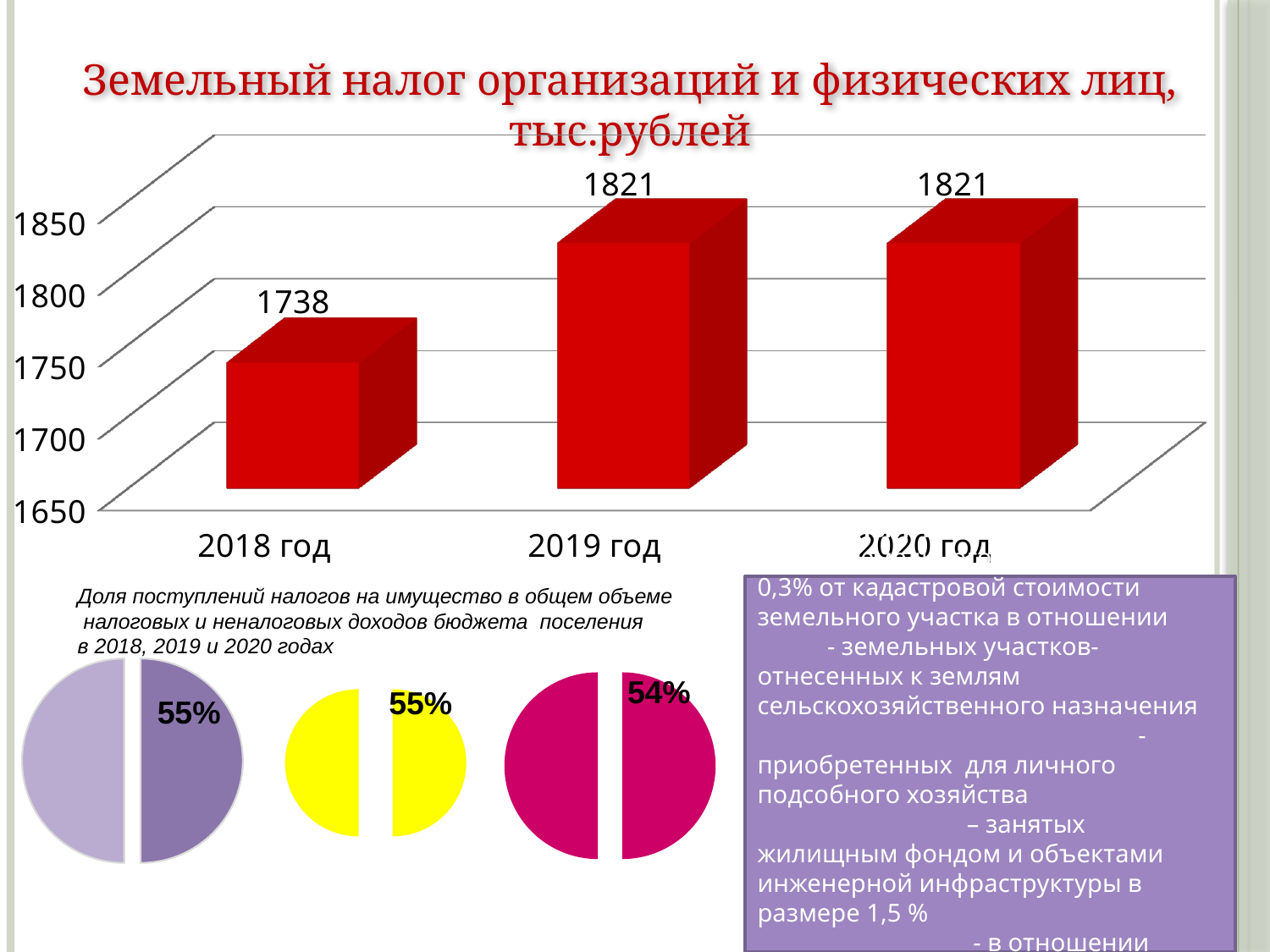
In the rightmost pie chart at the bottom of the slide, what share is shown by the labelled slice? 54% In the leftmost pie chart at the bottom of the slide, what share is shown by the labelled slice? 55% In the bar chart 'Земельный налог организаций и физических лиц, тыс.рублей', what is the difference between the values for 2019 год and 2018 год? 83 In the bar chart 'Земельный налог организаций и физических лиц, тыс.рублей', which year has the lowest value? 2018 год In the bar chart 'Земельный налог организаций и физических лиц, тыс.рублей', which is larger: the value for 2018 год or the value for 2019 год? 2019 год In the bar chart 'Земельный налог организаций и физических лиц, тыс.рублей', what is the value for 2020 год? 1821 In the bar chart 'Земельный налог организаций и физических лиц, тыс.рублей', do the values rise or fall from 2018 год to 2019 год? rise In the bar chart 'Земельный налог организаций и физических лиц, тыс.рублей', what is the value for 2019 год? 1821 What kind of chart is the chart titled 'Земельный налог организаций и физических лиц, тыс.рублей'? bar chart In the bar chart 'Земельный налог организаций и физических лиц, тыс.рублей', is the value for 2018 год greater or less than 1750? less How many years are shown in the bar chart 'Земельный налог организаций и физических лиц, тыс.рублей'? 3 In the bar chart 'Земельный налог организаций и физических лиц, тыс.рублей', what is the value for 2018 год? 1738